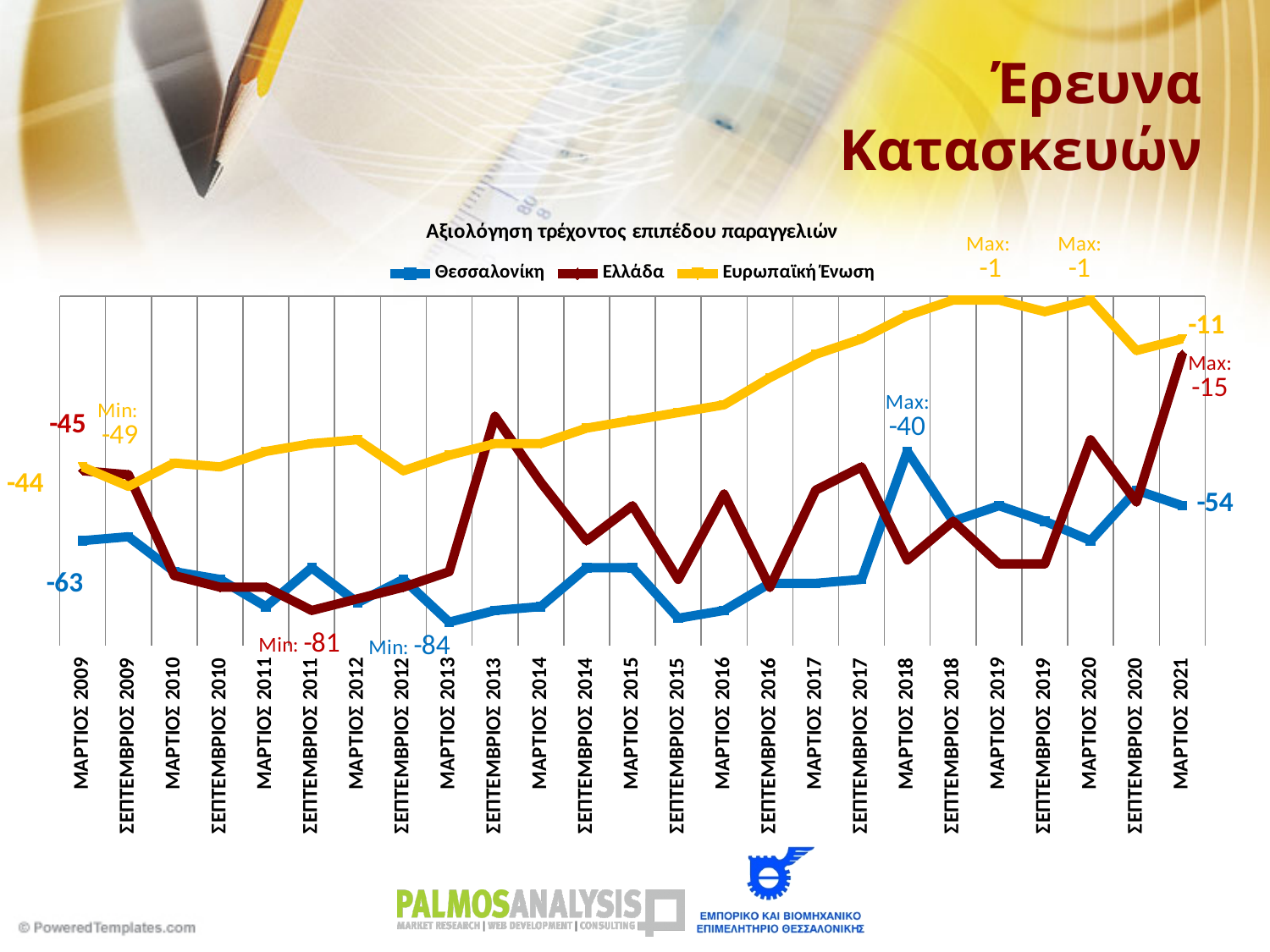
What is the lowest value reached by the Θεσσαλονίκη series? -84 In ΜΑΡΤΙΟΣ 2021, which is higher: the value for Ελλάδα or the value for Θεσσαλονίκη? Ελλάδα How many series does the legend of the chart list? 3 What is the value for Ευρωπαϊκή Ένωση in ΜΑΡΤΙΟΣ 2021? -11 What is the value for Θεσσαλονίκη in ΜΑΡΤΙΟΣ 2009? -63 In which period does the Θεσσαλονίκη series reach its maximum of -40? ΜΑΡΤΙΟΣ 2018 What is the value for Ελλάδα in ΜΑΡΤΙΟΣ 2021? -15 What kind of chart is shown on the slide? Line chart Which colour represents Ευρωπαϊκή Ένωση in the chart? Yellow By how much did the Θεσσαλονίκη value change from ΜΑΡΤΙΟΣ 2009 (-63) to ΜΑΡΤΙΟΣ 2021 (-54)? 9 How many time points are shown on the x axis of the chart? 25 What is the lowest value reached by the Ελλάδα series? -81